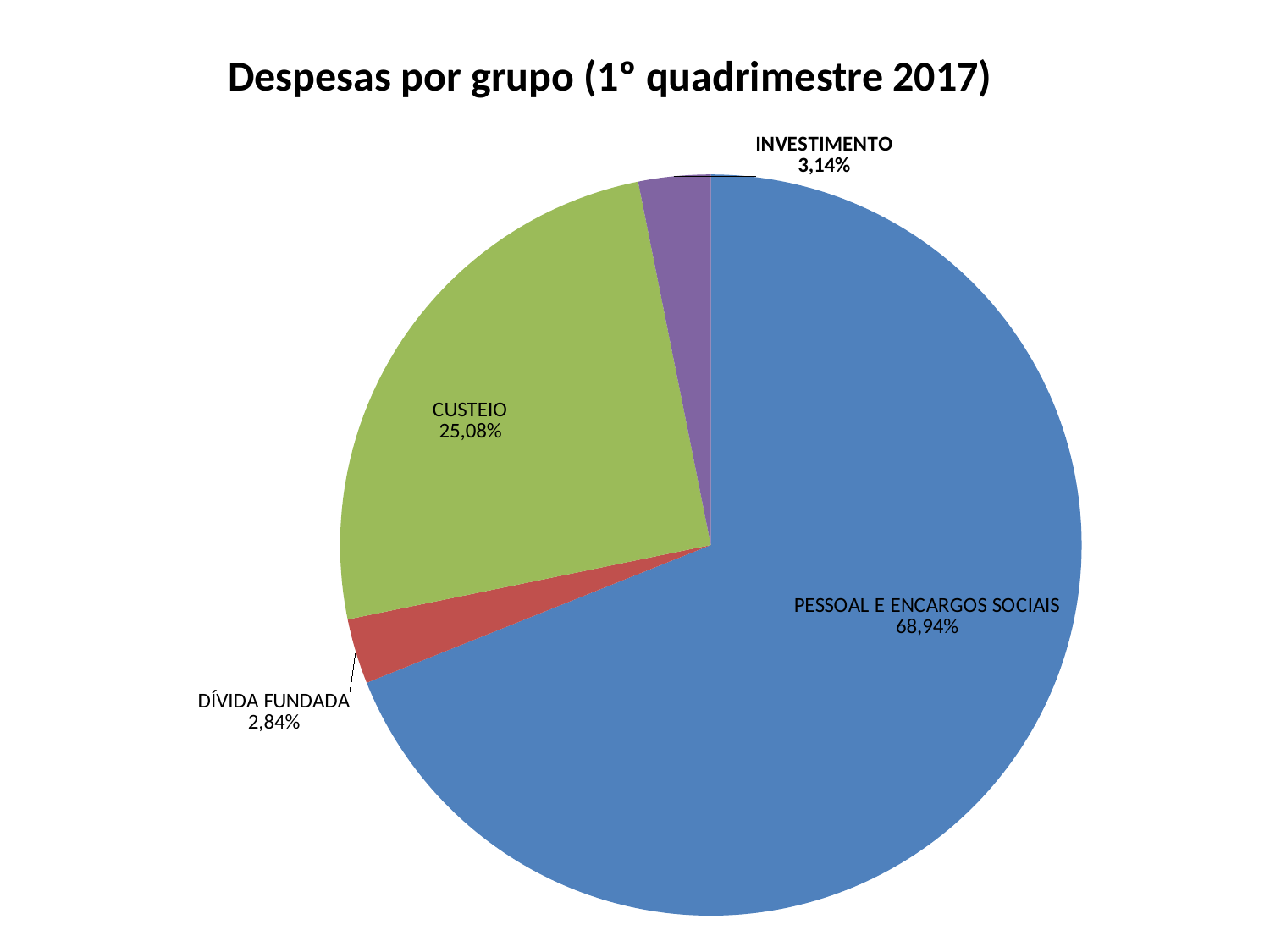
Which group has the smallest share of expenses? DÍVIDA FUNDADA What share of expenses does INVESTIMENTO represent? 3,14% What share of expenses does DÍVIDA FUNDADA represent? 2,84% What share of expenses does CUSTEIO represent? 25,08% Which has a larger share, CUSTEIO or INVESTIMENTO? CUSTEIO What is the difference in percentage points between INVESTIMENTO and DÍVIDA FUNDADA? 0,30 Which group has the largest share of expenses? PESSOAL E ENCARGOS SOCIAIS What is the difference in percentage points between PESSOAL E ENCARGOS SOCIAIS and CUSTEIO? 43,86 What is the title of the chart? Despesas por grupo (1° quadrimestre 2017) How many groups are shown in the pie chart? 4 What kind of chart is shown on the slide? Pie chart